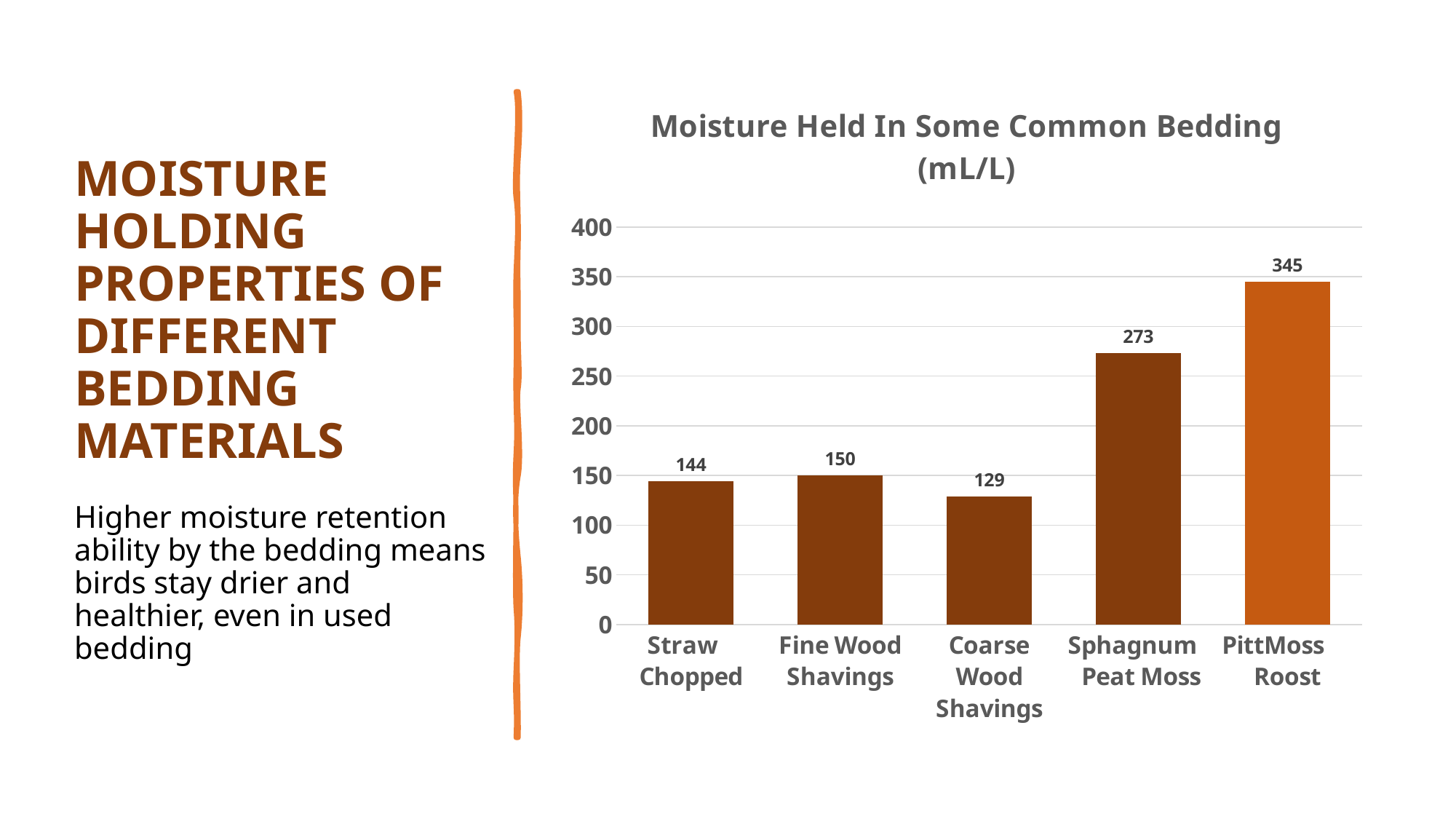
What is the title of the chart? Moisture Held In Some Common Bedding (mL/L) Which bedding material holds the least moisture? Coarse Wood Shavings Which bedding material holds the most moisture? PittMoss Roost What is the moisture held value for Coarse Wood Shavings? 129 What is the moisture held value for Straw Chopped? 144 What is the moisture held value for Sphagnum Peat Moss? 273 What kind of chart is shown on the slide? Bar chart Which holds more moisture, Fine Wood Shavings or Straw Chopped? Fine Wood Shavings Is the value for Sphagnum Peat Moss greater or less than 250? greater What is the difference in moisture held between Fine Wood Shavings and Coarse Wood Shavings? 21 How many bedding materials are shown in the chart? 5 What is the difference in moisture held between PittMoss Roost and Sphagnum Peat Moss? 72